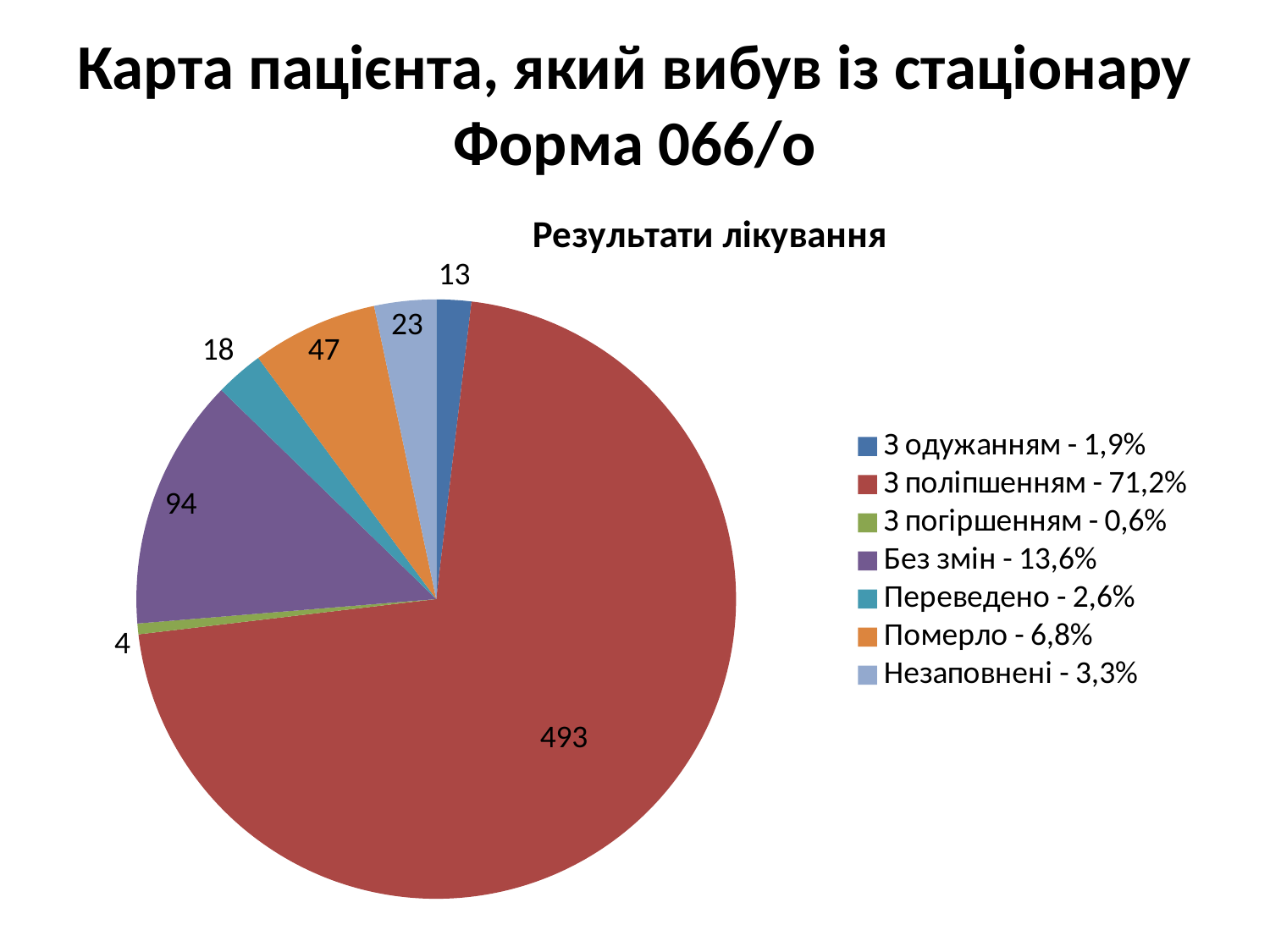
What is the title of the chart? Результати лікування What is the value shown for the 'Померло' slice? 47 Which category has the largest slice of the pie? З поліпшенням Which category has the smallest slice of the pie? З погіршенням What is the value shown for the 'З поліпшенням' slice? 493 What is the difference between the values for 'Без змін' and 'Померло'? 47 How many slices does the pie chart have? 7 What kind of chart is shown on the slide? pie chart What is the value shown for the 'Незаповнені' slice? 23 What is the value shown for the 'Без змін' slice? 94 According to the legend, what share of the pie does 'Без змін' represent? 13,6% Which is larger, the value for 'Переведено' or the value for 'З одужанням'? Переведено